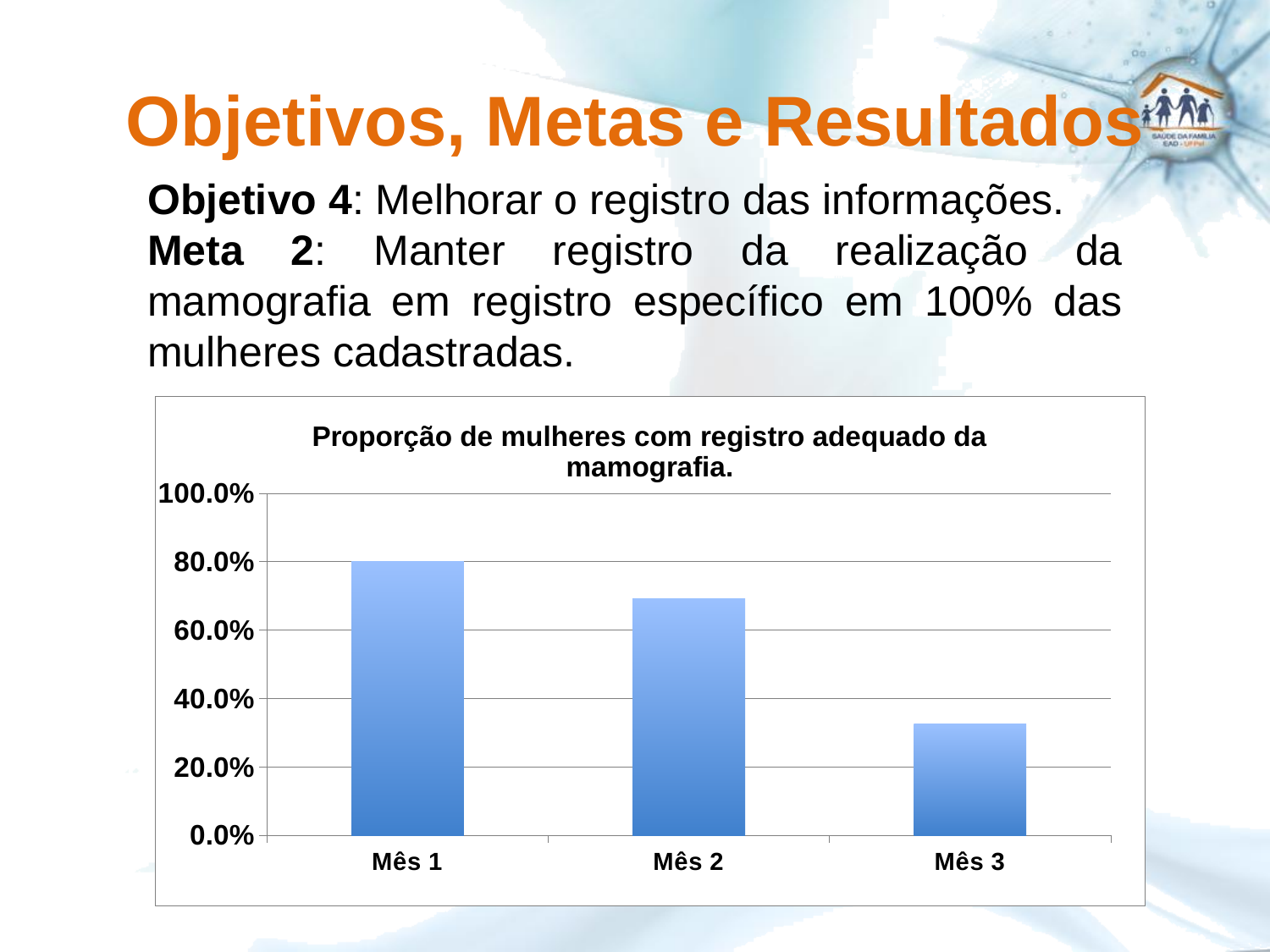
Is the value for Mês 2 greater or less than 80.0%? less Is the value for Mês 3 greater or less than 20.0%? greater Do the values rise or fall from Mês 1 to Mês 3? fall What is the value for Mês 1 in the chart? 80.0% How many months (categories) are shown on the x axis of the chart? 3 Is the value for Mês 3 greater or less than 40.0%? less What kind of chart is shown on the slide? bar chart What is the title of the chart? Proporção de mulheres com registro adequado da mamografia. Which month has the lowest proportion in the chart? Mês 3 Which is larger, the value for Mês 2 or the value for Mês 3? Mês 2 Which month has the highest proportion in the chart? Mês 1